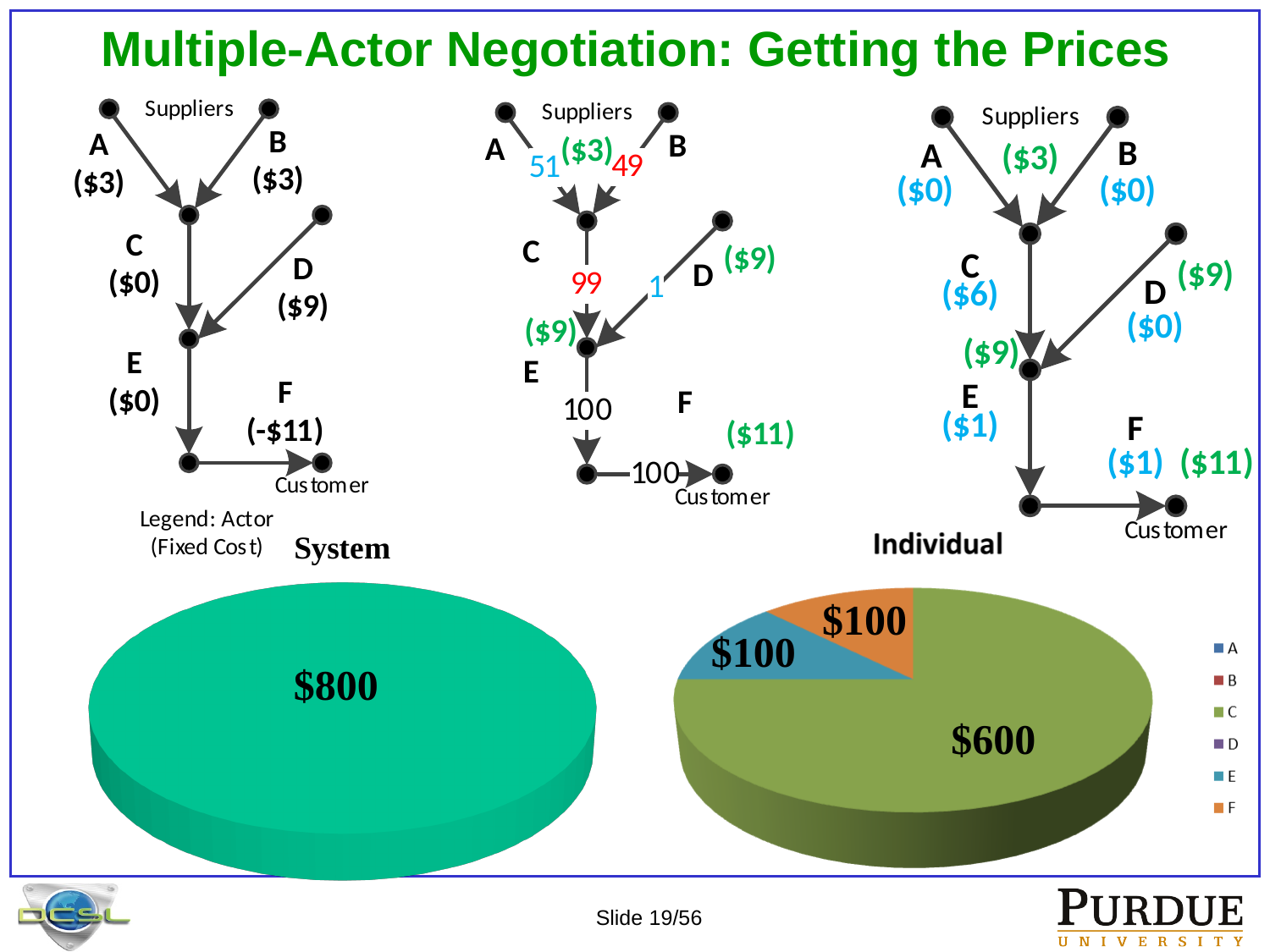
What is the title of the pie chart on the right side of the slide? Individual In the "Individual" pie chart, what share of the total do the $600 slice represent? 75% In the "Individual" pie chart, which is larger, the green slice or the blue slice? the green slice What kind of chart is the chart titled "System"? pie chart In the "Individual" pie chart, what is the value of the largest slice? $600 In the "Individual" pie chart, what value is printed on the blue slice? $100 In the "Individual" pie chart, what is the difference between the green slice and the orange slice? $500 How many labelled slices are visible in the "Individual" pie chart? 3 How many entries does the legend of the "Individual" pie chart list? 6 In the "System" pie chart, what value is printed on the single slice? $800 In the "Individual" pie chart, what value is printed on the orange slice? $100 In the "Individual" pie chart, what is the total of the three labelled slices? $800